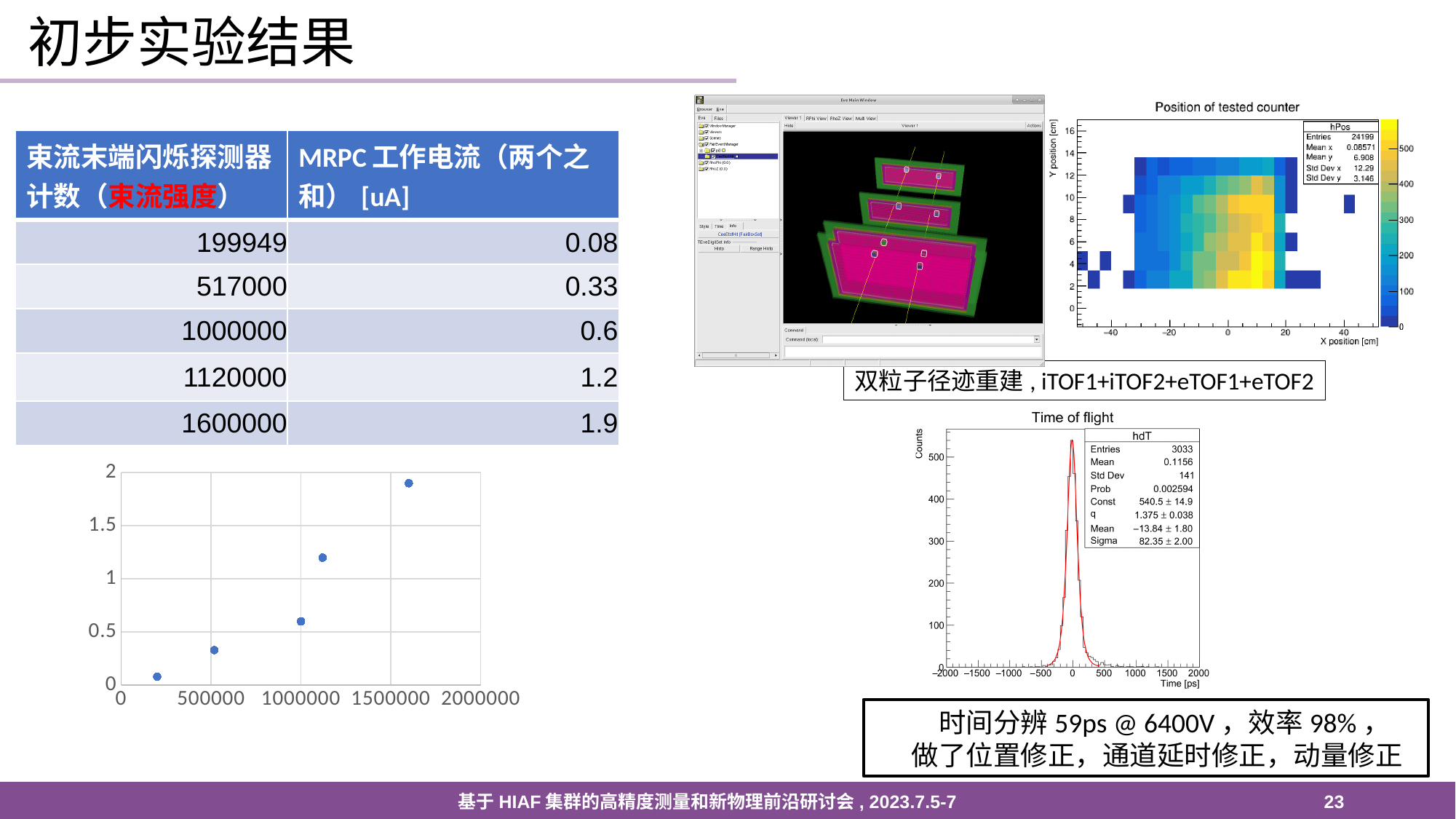
In the bottom-left scatter chart, do the values rise or fall as the x-axis value increases? rise In the 'Time of flight' chart, how many entries does the stats box report? 3033 In the bottom-left scatter chart, is the value for the point at 517000 greater or less than 0.5? less In the bottom-left scatter chart, is the value for the point at 1120000 greater or less than 1? greater In the bottom-left scatter chart, what is the MRPC working current at a scintillator count of 1000000? 0.6 What kind of chart is the chart at the bottom left of the slide? scatter chart In the 'Position of tested counter' chart, how many entries does the stats box report? 24199 In the bottom-left scatter chart, which has the larger MRPC current: the point at 1120000 or the point at 1000000? 1120000 In the bottom-left scatter chart, what is the lowest MRPC working current plotted? 0.08 In the bottom-left scatter chart, what is the difference between the MRPC current at 1600000 and at 199949? 1.82 How many data points are plotted in the bottom-left scatter chart? 5 In the bottom-left scatter chart, what is the highest MRPC working current plotted? 1.9